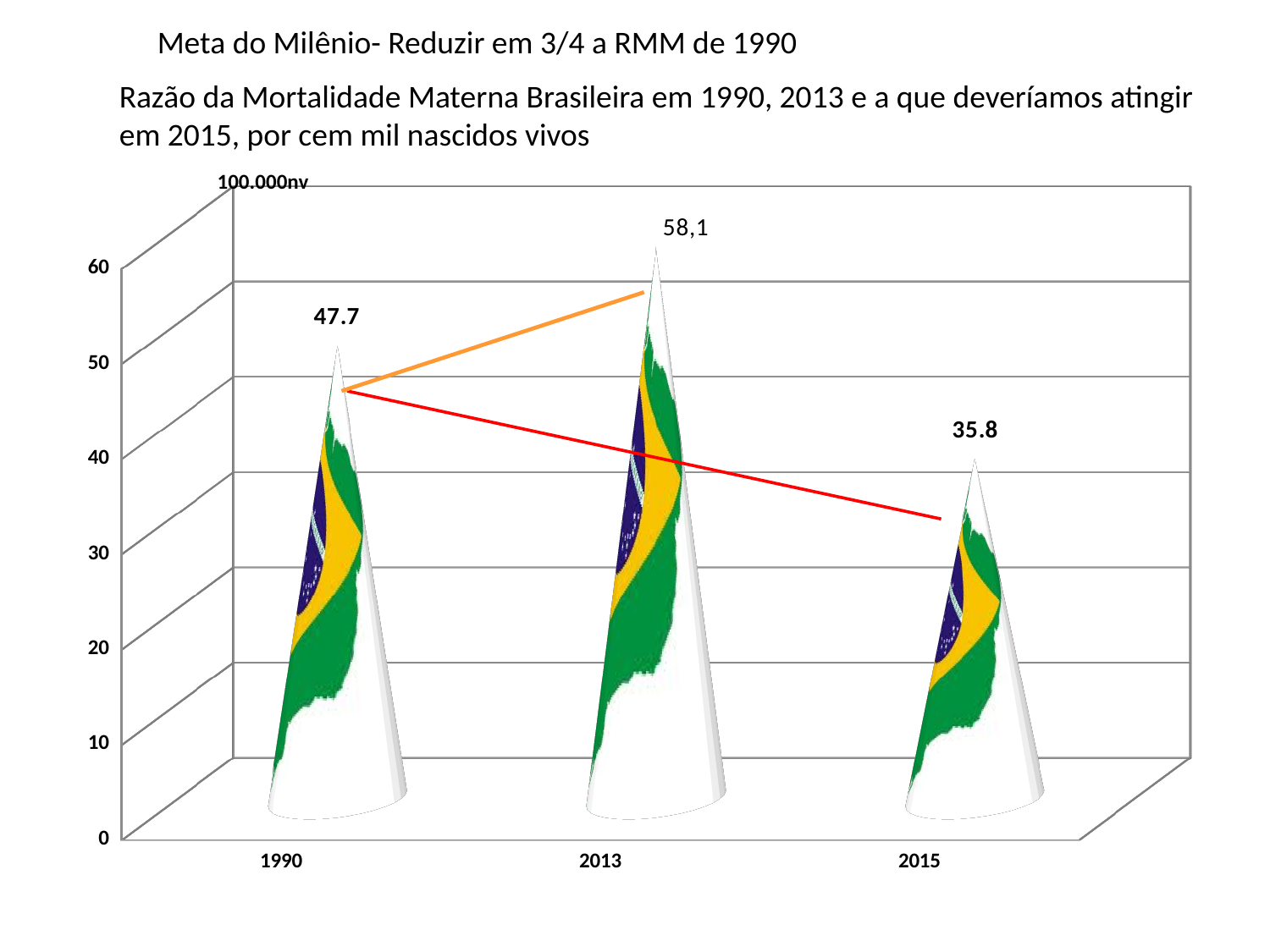
What is the value shown for 2015? 35.8 Is the value for 2013 greater or less than 50? greater What kind of chart is shown on the slide? bar chart Which is larger, the value for 1990 or the value for 2015? 1990 What is the value shown for 2013? 58,1 Which year has the highest value? 2013 What is the value shown for 1990? 47.7 Does the value rise or fall from 2013 to 2015? fall How many years are shown on the x axis? 3 What is the difference between the values for 2013 and 1990? 10.4 What is the difference between the values for 1990 and 2015? 11.9 Which year has the lowest value? 2015